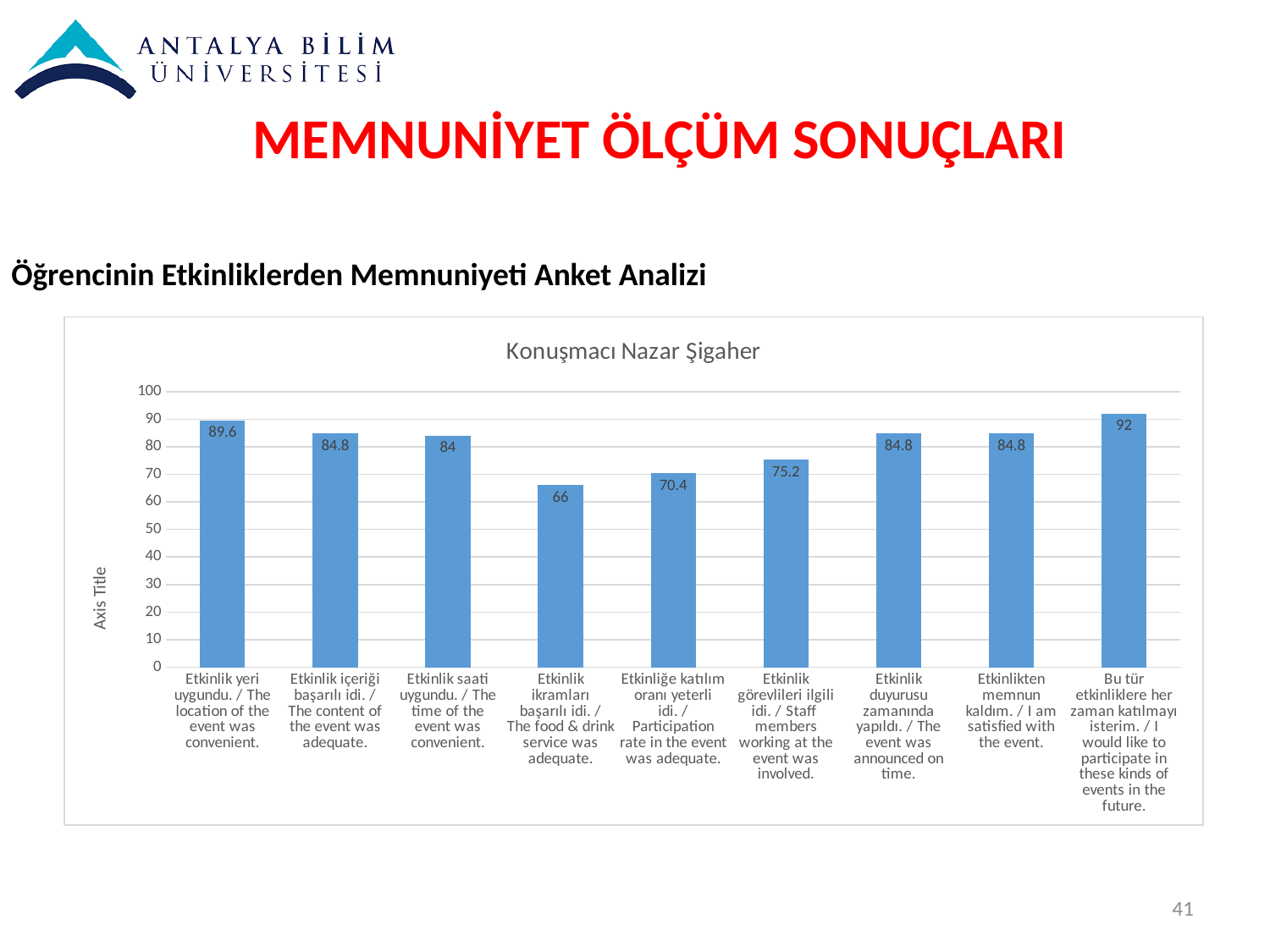
What is the value for 'The location of the event was convenient'? 89.6 Which is larger: the value for 'The time of the event was convenient' or the value for 'Participation rate in the event was adequate'? The time of the event was convenient Is the value for 'The event was announced on time' greater or less than 80? greater What is the value for 'The food & drink service was adequate'? 66 What is the value for 'Staff members working at the event was involved'? 75.2 What is the difference between the highest value (92) and the lowest value (66)? 26 What is the difference between the value for 'The content of the event was adequate' and the value for 'The time of the event was convenient'? 0.8 What is the title of the chart? Konuşmacı Nazar Şigaher Which category has the lowest value? Etkinlik ikramları başarılı idi. / The food & drink service was adequate. Which category has the highest value? Bu tür etkinliklere her zaman katılmayı isterim. / I would like to participate in these kinds of events in the future. What kind of chart is shown on the slide? Bar chart How many categories are shown on the x axis? 9